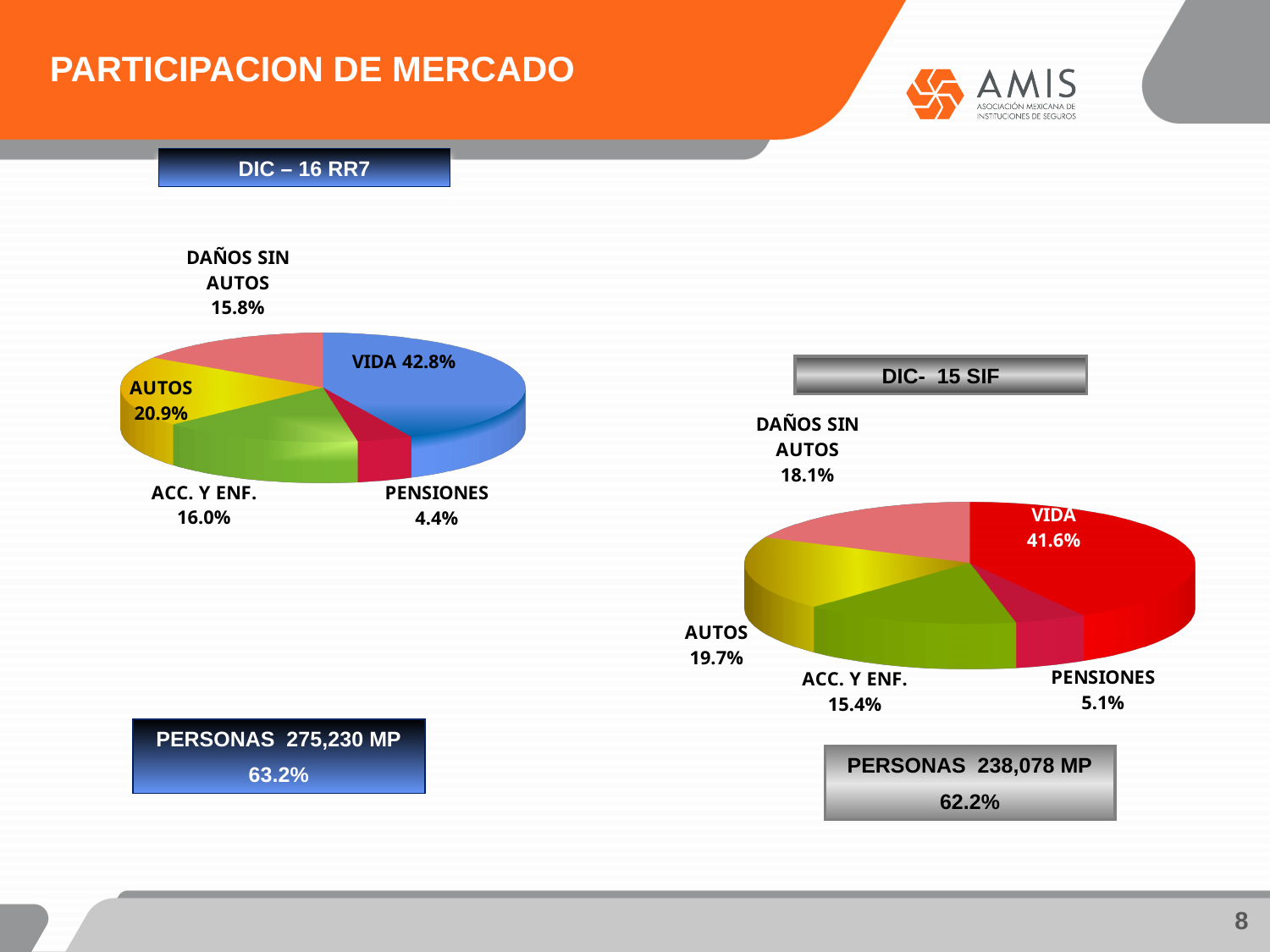
In the DIC- 15 SIF pie chart, which is larger: AUTOS or DAÑOS SIN AUTOS? AUTOS In the DIC – 16 RR7 pie chart, which category has the largest share? VIDA In the DIC- 15 SIF pie chart, what share does PENSIONES have? 5.1% In the DIC – 16 RR7 pie chart, what is the value for AUTOS? 20.9% In the DIC – 16 RR7 pie chart, what share does VIDA have? 42.8% In the DIC- 15 SIF pie chart, what is the value for DAÑOS SIN AUTOS? 18.1% How many categories are shown in the DIC – 16 RR7 pie chart? 5 In the DIC – 16 RR7 pie chart, what is the difference between the AUTOS share and the ACC. Y ENF. share? 4.9% What is the title of the pie chart on the left side of the slide? DIC – 16 RR7 In the DIC- 15 SIF pie chart, which category has the smallest share? PENSIONES What kind of chart is the DIC- 15 SIF chart? Pie chart What is the difference between the VIDA share in the DIC – 16 RR7 chart and the VIDA share in the DIC- 15 SIF chart? 1.2%